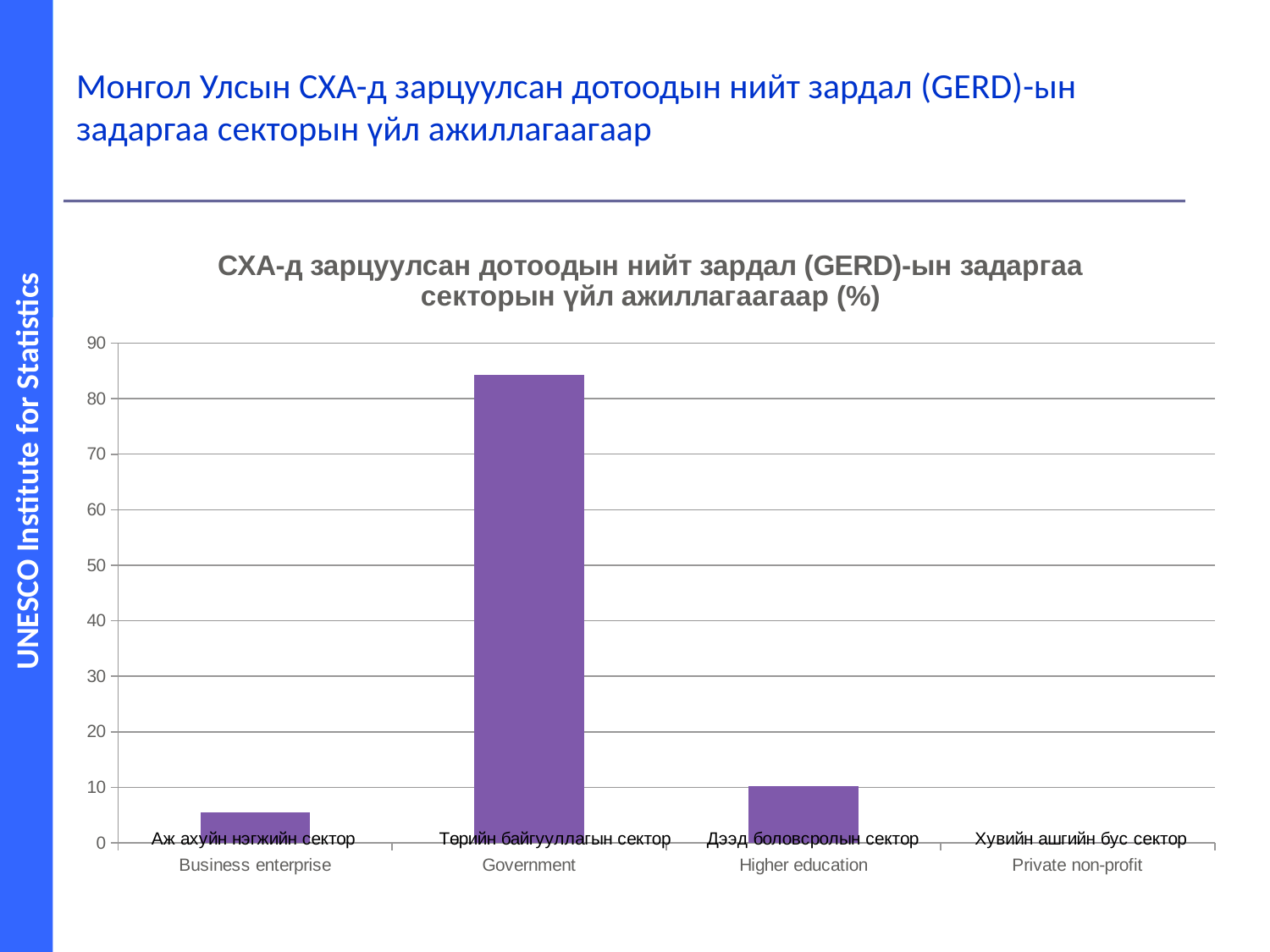
Which sector shows no visible bar in the chart? Private non-profit Which is larger, the value for Government or the value for Higher education? Government What is the maximum value shown on the vertical axis of the chart? 90 What colour are the bars in the chart? purple How many sector categories are shown on the x axis of the chart? 4 Which is larger, the value for Higher education or the value for Business enterprise? Higher education Which sector has the highest share of GERD in the chart? Government Is the value for Business enterprise greater or less than 10? less Is the value for Higher education greater or less than 20? less Is the value for Government greater or less than 90? less What kind of chart is shown on the slide? bar chart